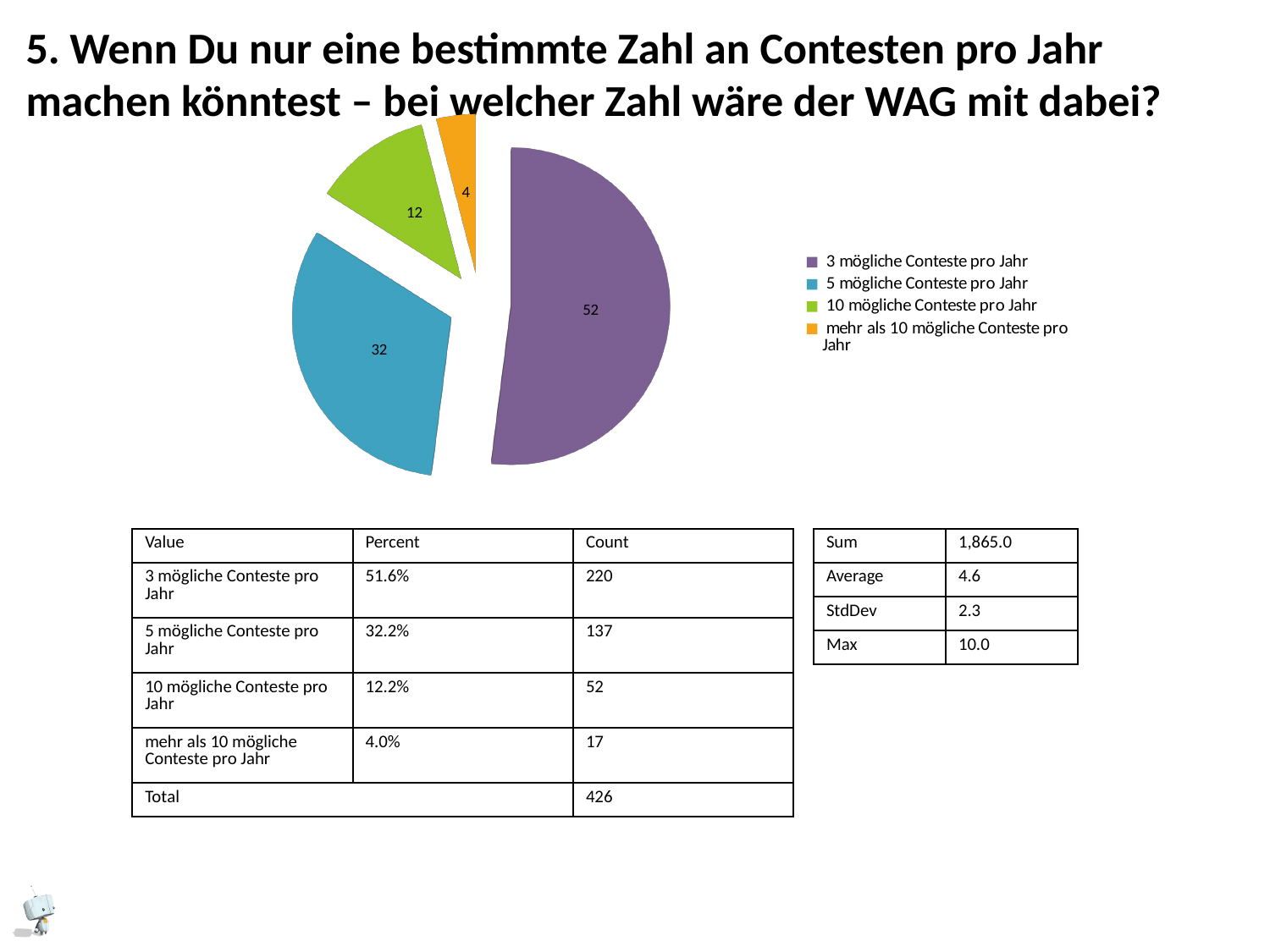
What is the difference between the data labels for '3 mögliche Conteste pro Jahr' and '5 mögliche Conteste pro Jahr'? 20 Which category has the largest slice in the pie chart? 3 mögliche Conteste pro Jahr What is the data label on the slice for '5 mögliche Conteste pro Jahr'? 32 What colour is the slice for '5 mögliche Conteste pro Jahr' in the pie chart? blue What is the data label on the slice for '3 mögliche Conteste pro Jahr'? 52 What is the data label on the slice for '10 mögliche Conteste pro Jahr'? 12 What is the data label on the slice for 'mehr als 10 mögliche Conteste pro Jahr'? 4 Which slice is larger: '10 mögliche Conteste pro Jahr' or 'mehr als 10 mögliche Conteste pro Jahr'? 10 mögliche Conteste pro Jahr Which category has the smallest slice in the pie chart? mehr als 10 mögliche Conteste pro Jahr How many slices does the pie chart have? 4 How many entries does the legend of the pie chart list? 4 What kind of chart is shown on the slide? pie chart